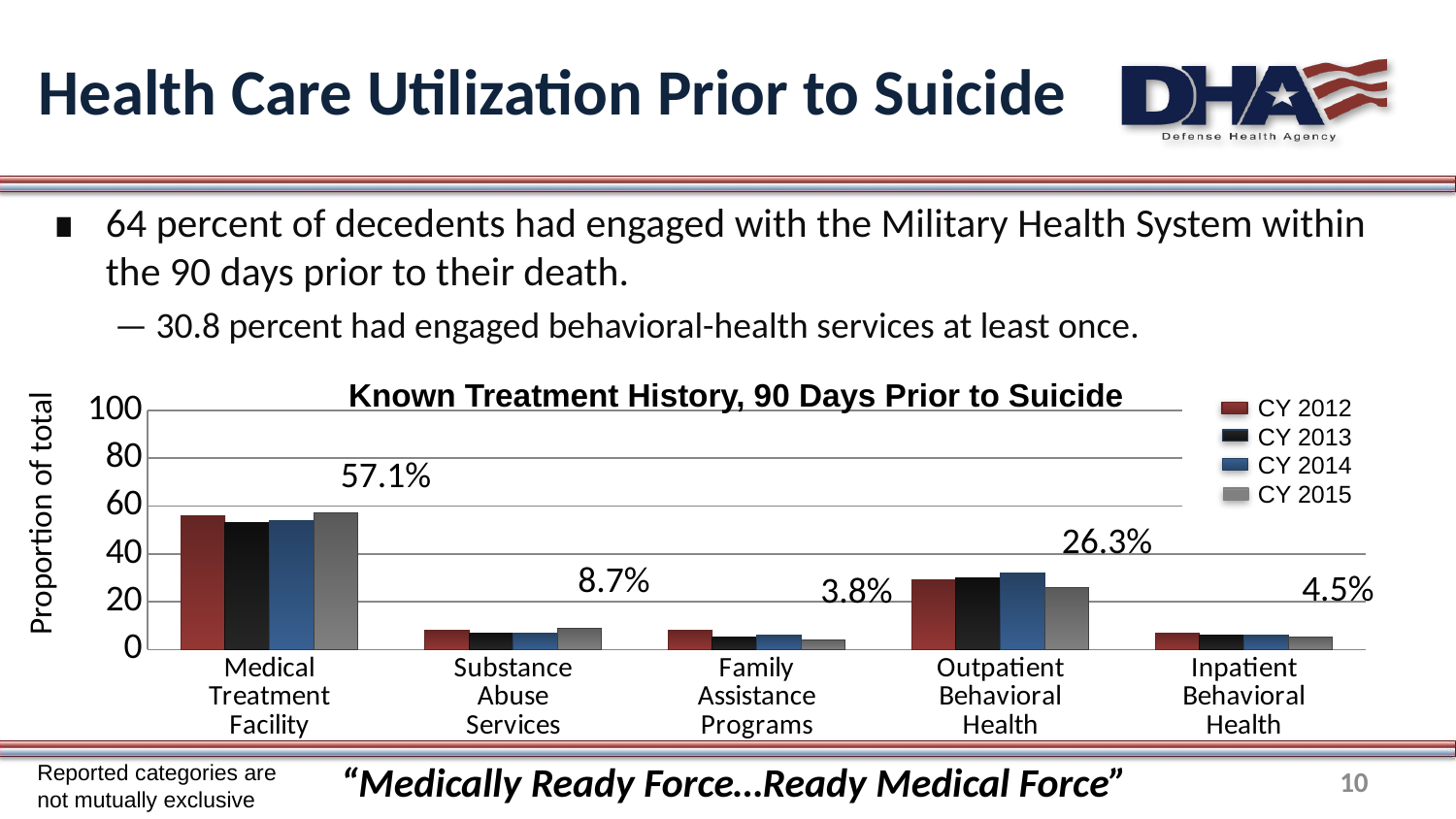
What is the labeled CY 2015 value for Outpatient Behavioral Health? 26.3% What is the labeled CY 2015 value for Family Assistance Programs? 3.8% How many treatment categories are shown on the x axis of the chart? 5 What is the difference between the labeled CY 2015 values for Medical Treatment Facility and Outpatient Behavioral Health? 30.8 percentage points What is the labeled CY 2015 value for Medical Treatment Facility? 57.1% Which category has the highest labeled CY 2015 value? Medical Treatment Facility Which category has the lowest labeled CY 2015 value? Family Assistance Programs Is the CY 2012 value for Medical Treatment Facility greater or less than 40? greater What is the labeled CY 2015 value for Substance Abuse Services? 8.7% What is the labeled CY 2015 value for Inpatient Behavioral Health? 4.5% What kind of chart is shown on the slide? Bar chart How many series does the legend of the chart list? 4